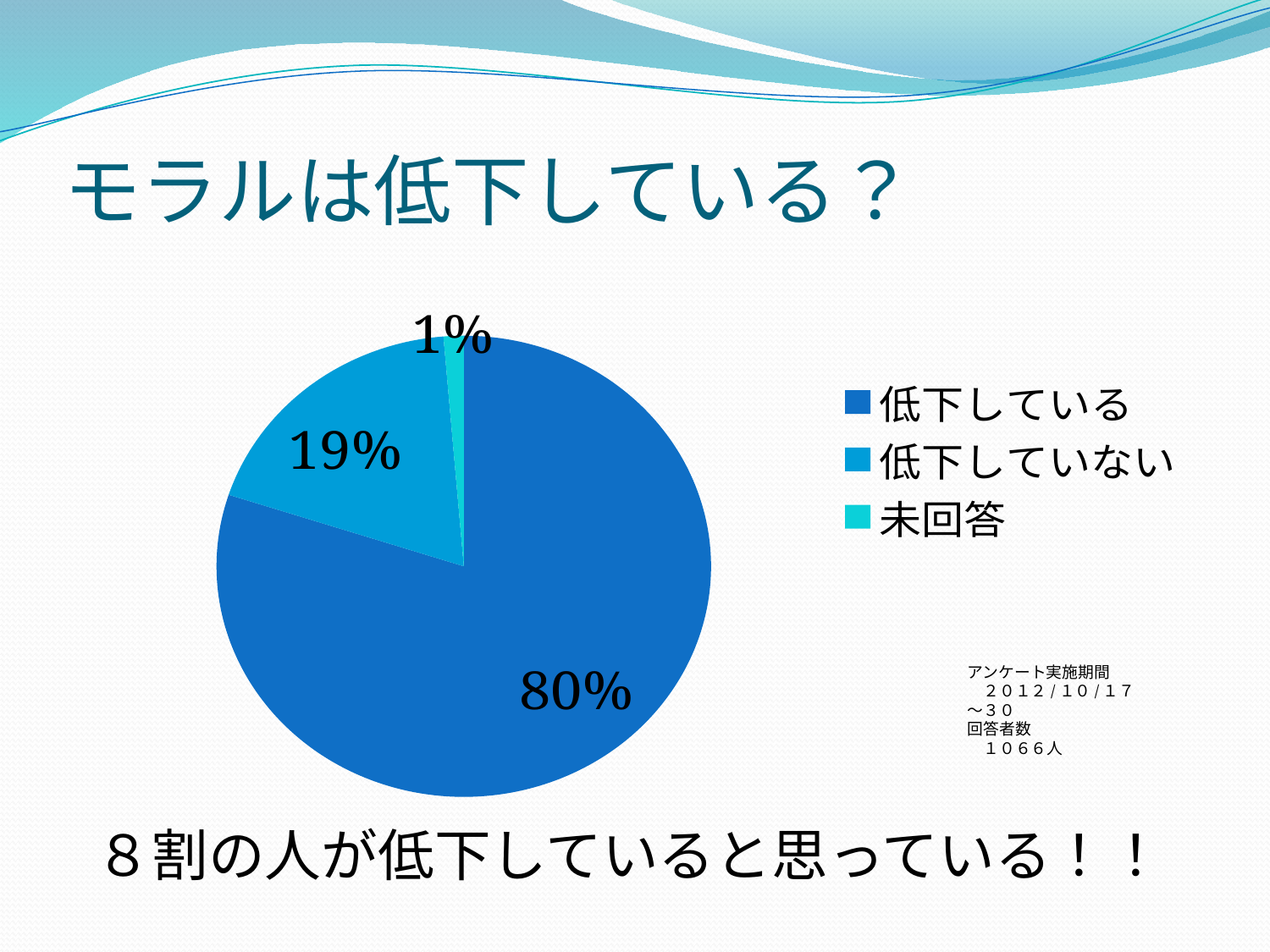
Which is larger, the slice for 低下していない or the slice for 未回答? 低下していない Which category has the largest slice of the pie? 低下している What share of the pie does 低下していない take? 19% What is the title of the slide containing the pie chart? モラルは低下している？ What share of the pie does 低下している take? 80% Is the share for 低下している greater or less than 50%? greater How many categories does the pie chart have? 3 What is the difference in percentage points between 低下している and 低下していない? 61 What kind of chart is shown on the slide? pie chart How many entries does the legend list? 3 Which category has the smallest slice of the pie? 未回答 What share of the pie does 未回答 take? 1%